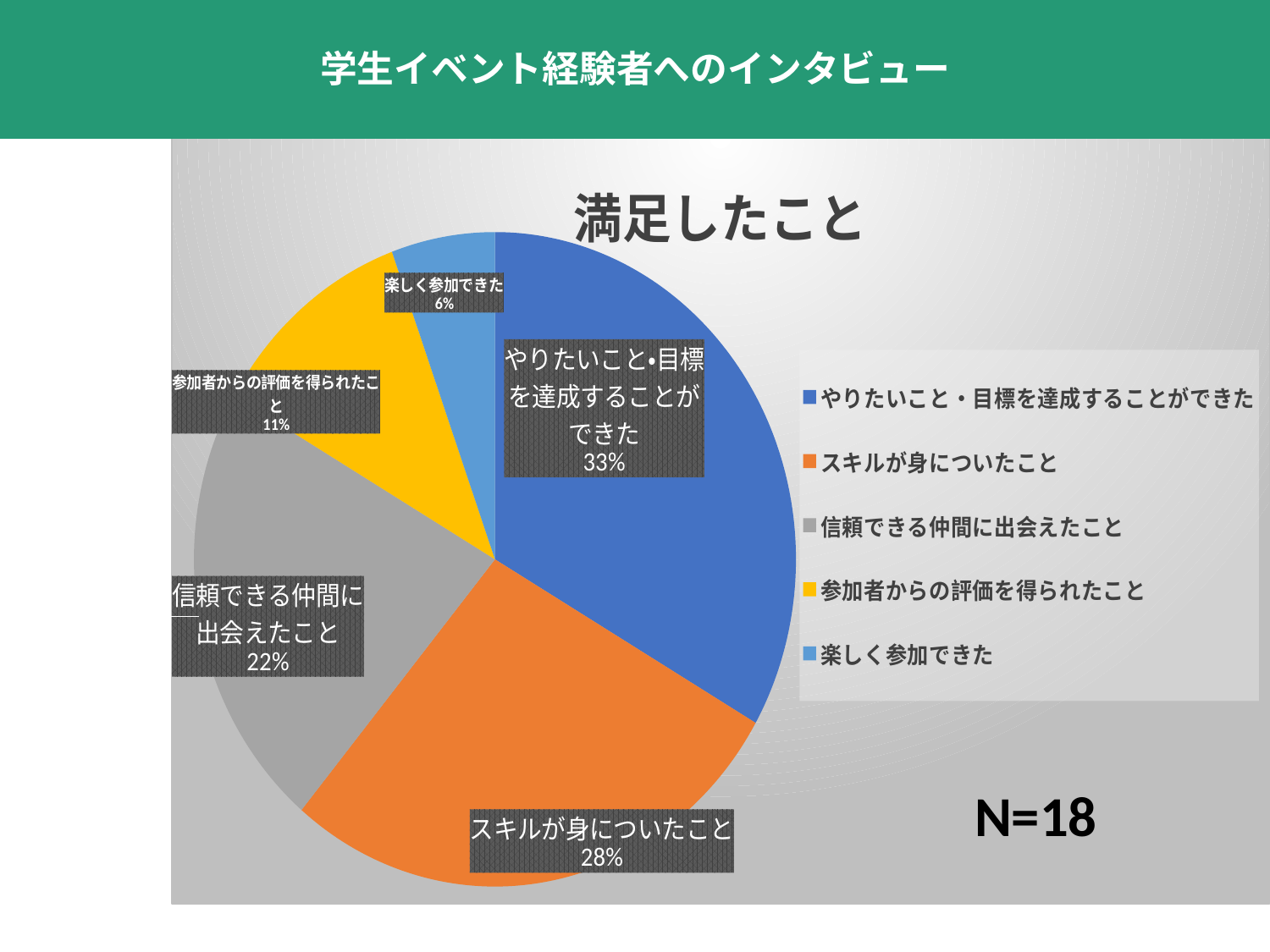
What share of the pie does 「楽しく参加できた」 have? 6% What share of the pie does 「やりたいこと・目標を達成することができた」 have? 33% Which category has the largest slice of the pie? やりたいこと・目標を達成することができた Which is larger, the share for 「信頼できる仲間に出会えたこと」 or the share for 「参加者からの評価を得られたこと」? 信頼できる仲間に出会えたこと How many categories does the pie chart have? 5 Which category has the smallest slice of the pie? 楽しく参加できた What kind of chart is shown on the slide? pie chart What share of the pie does 「スキルが身についたこと」 have? 28% What is the difference in percentage points between 「やりたいこと・目標を達成することができた」 and 「スキルが身についたこと」? 5 percentage points What is the title of the chart? 満足したこと